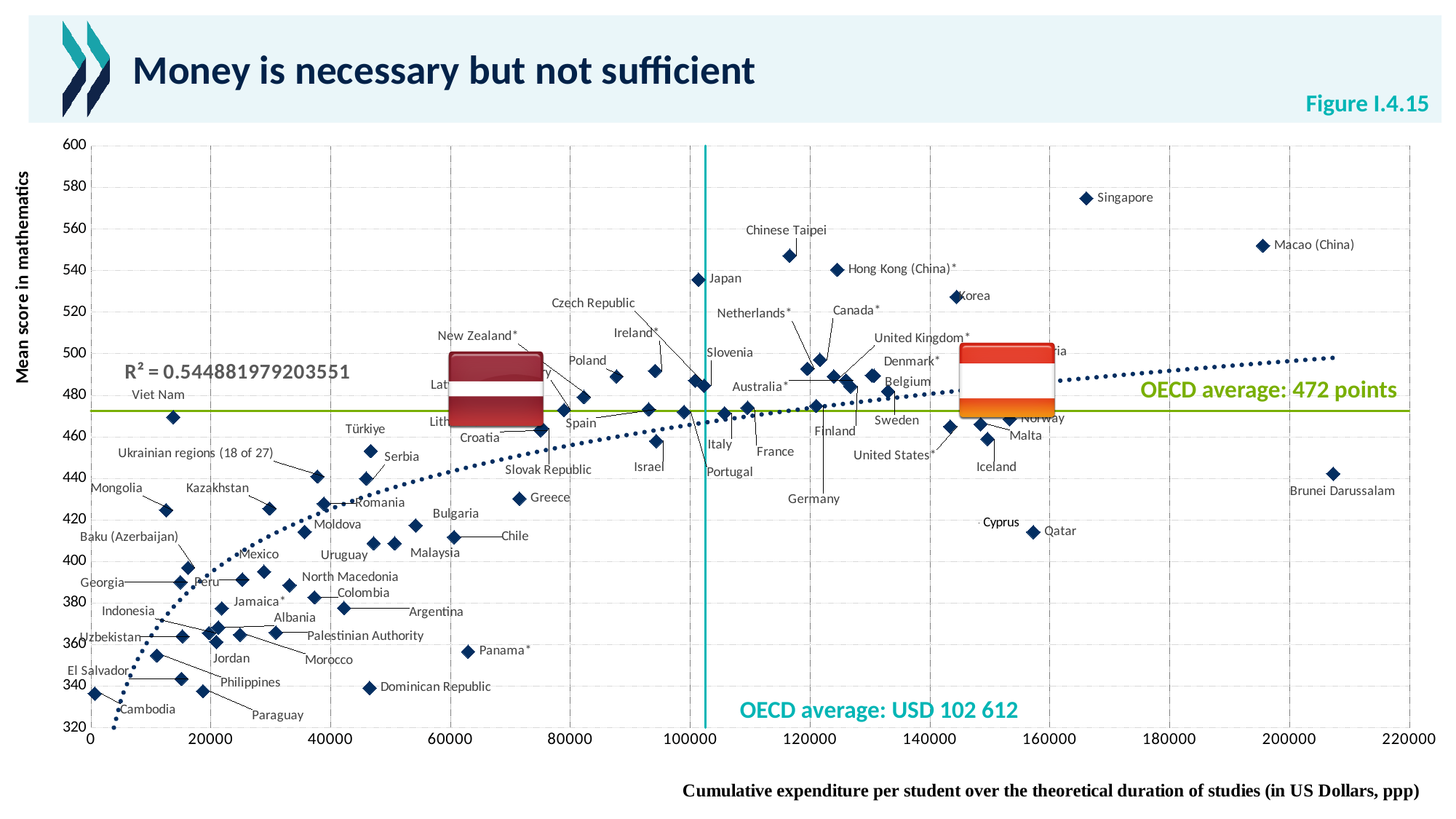
What is the OECD average mean score in mathematics marked by the horizontal line? 472 points Is the cumulative expenditure per student for Macao (China) greater or less than 180000? greater What R² value is printed on the chart? R² = 0.544881979203551 Overall, do mean mathematics scores rise or fall as cumulative expenditure per student increases along the x axis? Rise Which country has the lowest cumulative expenditure per student? Cambodia Which country has the highest mean score in mathematics? Singapore What is the OECD average cumulative expenditure per student marked by the vertical line? USD 102 612 Which has a higher mean score in mathematics, Panama or Dominican Republic? Panama What is the label of the x axis? Cumulative expenditure per student over the theoretical duration of studies (in US Dollars, ppp) Which country has the highest cumulative expenditure per student? Brunei Darussalam What kind of chart is shown on the slide? Scatter plot Is the mean score in mathematics for Singapore greater or less than 560? greater